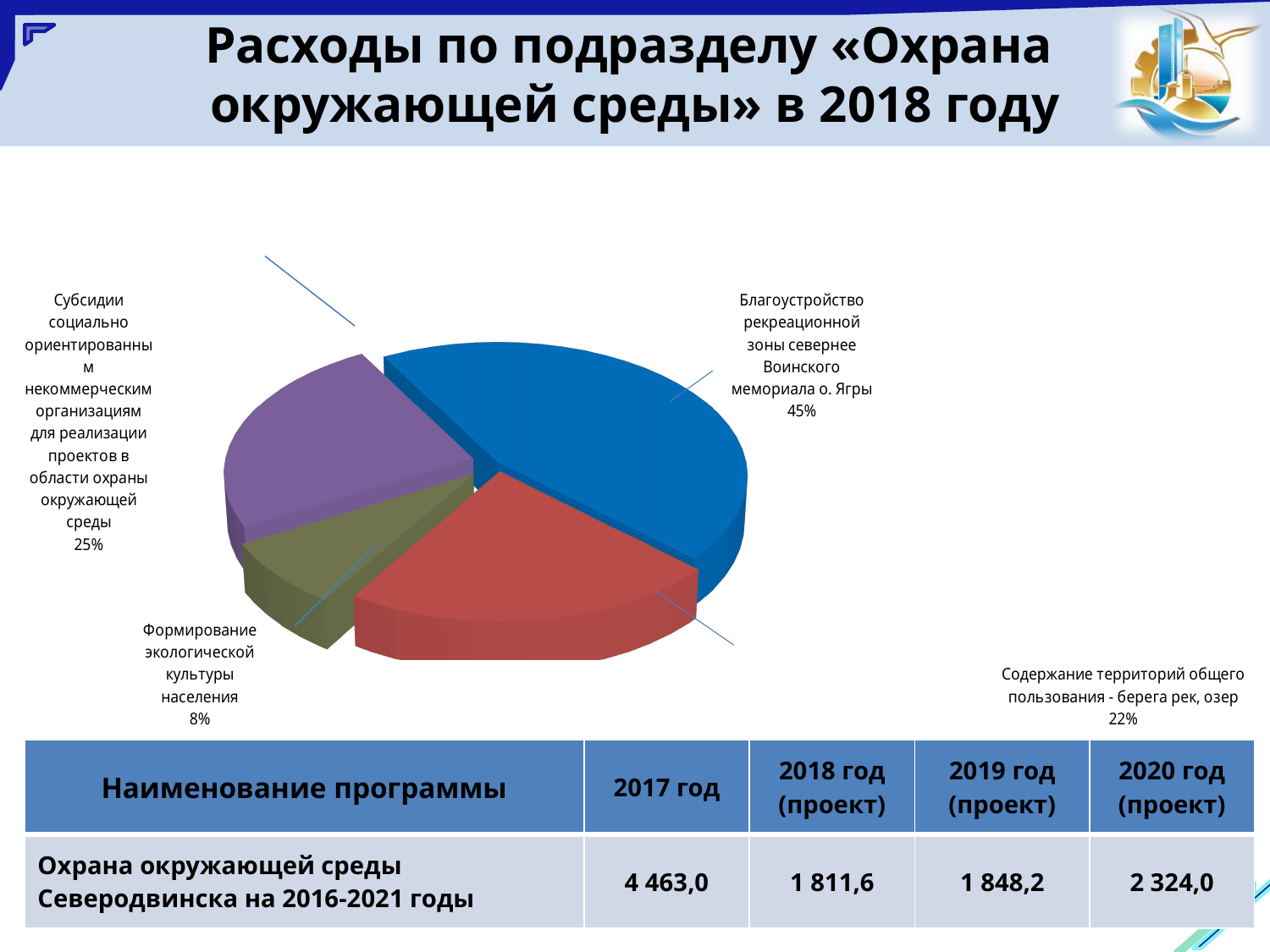
Какая доля расходов приходится на формирование экологической культуры населения? 8% Сколько секторов (категорий) на круговой диаграмме? 4 Какая доля расходов приходится на благоустройство рекреационной зоны севернее Воинского мемориала о. Ягры? 45% Каким цветом на диаграмме показан сектор «Благоустройство рекреационной зоны севернее Воинского мемориала о. Ягры»? синим Какой тип диаграммы показан на слайде? круговая диаграмма На сколько процентных пунктов доля субсидий социально ориентированным некоммерческим организациям больше доли формирования экологической культуры населения? 17 Какая категория имеет наибольшую долю на круговой диаграмме? Благоустройство рекреационной зоны севернее Воинского мемориала о. Ягры Какая категория имеет наименьшую долю на круговой диаграмме? Формирование экологической культуры населения Какая доля расходов приходится на содержание территорий общего пользования - берега рек, озер? 22% На сколько процентных пунктов доля благоустройства рекреационной зоны больше доли содержания территорий общего пользования? 23 Что больше: доля субсидий социально ориентированным некоммерческим организациям или доля содержания территорий общего пользования? Субсидии социально ориентированным некоммерческим организациям